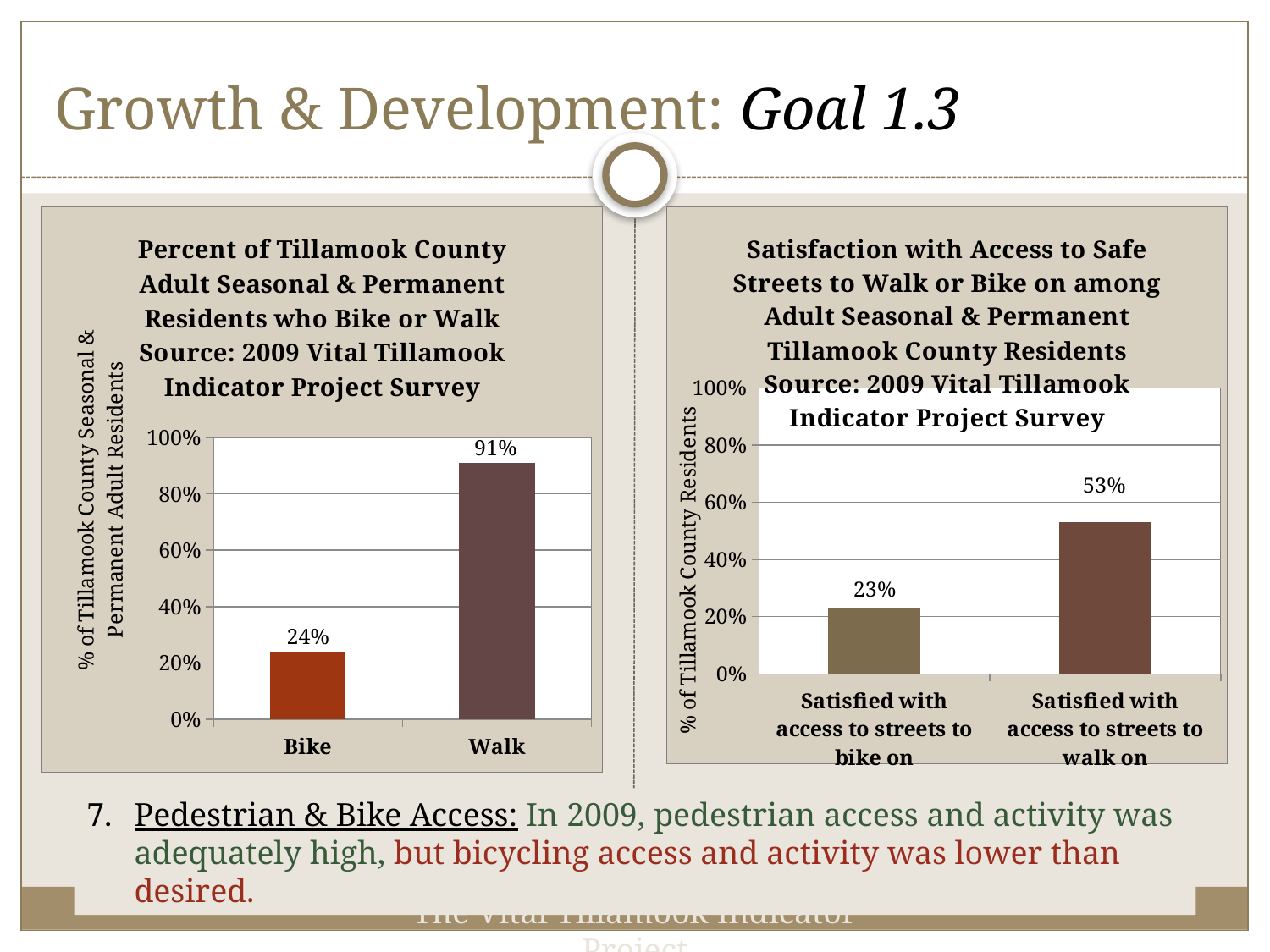
In the right chart (Satisfaction with Access to Safe Streets to Walk or Bike on), what is the value for 'Satisfied with access to streets to walk on'? 53% In the left chart (Percent of Tillamook County Adult Seasonal & Permanent Residents who Bike or Walk), which category has the highest value? Walk In the left chart (Percent of Tillamook County Adult Seasonal & Permanent Residents who Bike or Walk), how many categories are shown? 2 In the right chart (Satisfaction with Access to Safe Streets to Walk or Bike on), what is the value for 'Satisfied with access to streets to bike on'? 23% In the left chart (Percent of Tillamook County Adult Seasonal & Permanent Residents who Bike or Walk), what is the difference between the Walk and Bike values? 67% In the right chart (Satisfaction with Access to Safe Streets to Walk or Bike on), is the value for 'Satisfied with access to streets to walk on' greater or less than 40%? greater In the right chart (Satisfaction with Access to Safe Streets to Walk or Bike on), which category has the lowest value? Satisfied with access to streets to bike on In the right chart (Satisfaction with Access to Safe Streets to Walk or Bike on), what is the difference between the walk and bike satisfaction values? 30% What kind of chart is the left chart (Percent of Tillamook County Adult Seasonal & Permanent Residents who Bike or Walk)? Bar chart In the left chart (Percent of Tillamook County Adult Seasonal & Permanent Residents who Bike or Walk), what is the value for Walk? 91% What is the source cited in the title of the left chart? 2009 Vital Tillamook Indicator Project Survey In the left chart (Percent of Tillamook County Adult Seasonal & Permanent Residents who Bike or Walk), what is the value for Bike? 24%